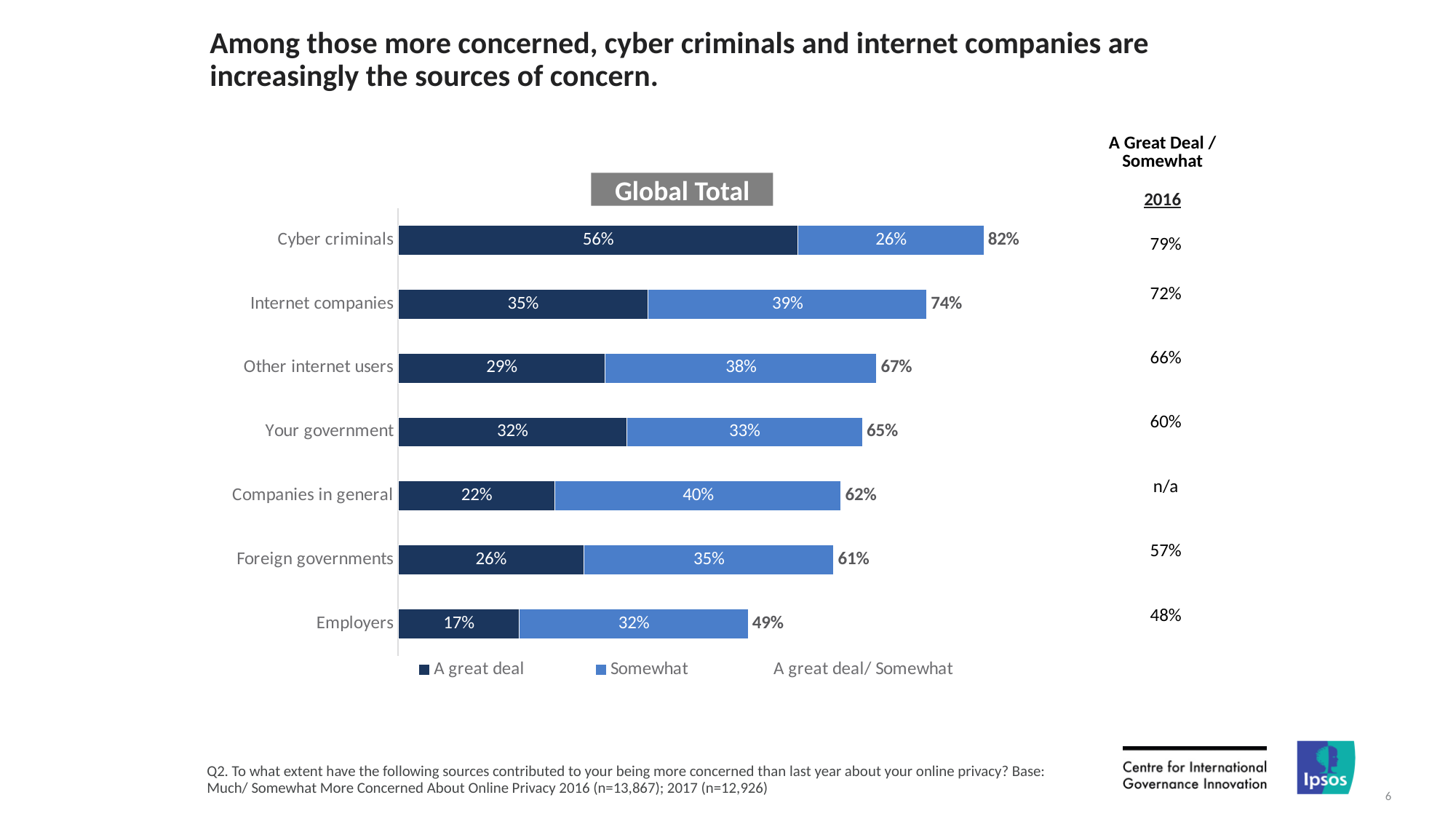
What is the difference between the 'A great deal' values for Cyber criminals and Internet companies? 21% What kind of chart is shown on the slide? Stacked bar chart What was the 2016 'A Great Deal / Somewhat' value for Your government shown in the column to the right of the chart? 60% What is the title shown above the chart? Global Total Which category has the highest combined 'A great deal/ Somewhat' total? Cyber criminals What is the 'Somewhat' value for Companies in general? 40% Which is larger: the 'Somewhat' value for Internet companies or for Other internet users? Internet companies What is the 'A great deal' value for Cyber criminals? 56% Which category has the lowest 'A great deal' value? Employers How many entries does the legend list? 3 How many categories are shown on the chart? 7 What is the combined 'A great deal/ Somewhat' total for Internet companies? 74%